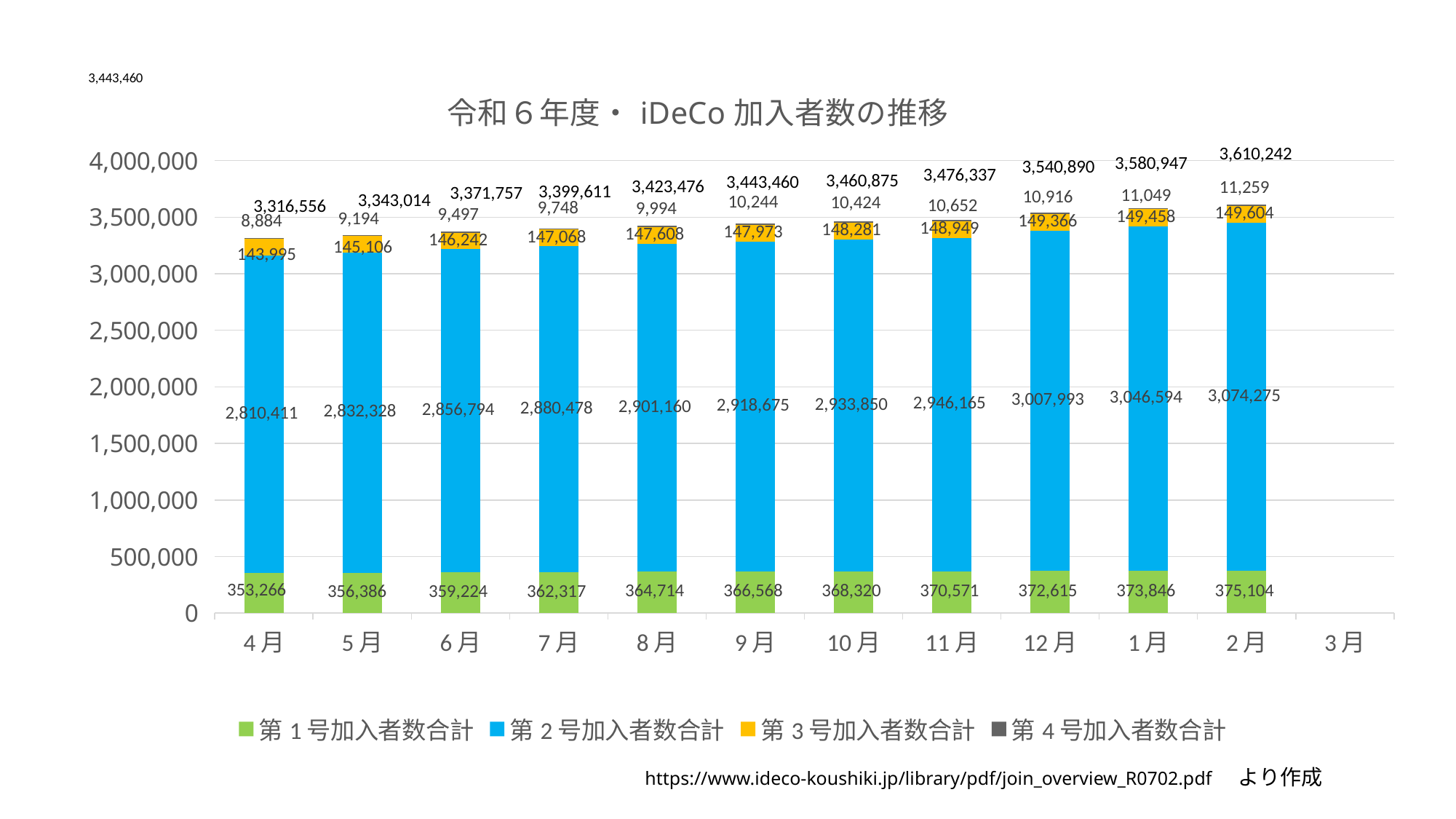
Which month with a bar has the lowest stacked total? 4月 What kind of chart is shown on the slide? Stacked bar chart What is the value of 第２号加入者数合計 for 4月? 2,810,411 What is the value of 第１号加入者数合計 for 2月? 375,104 How much larger is 第１号加入者数合計 in 2月 than in 4月? 21,838 Which month has the highest stacked total? 2月 What is the value of 第４号加入者数合計 for 12月? 10,916 How many series does the legend list? 4 Which is larger, 第２号加入者数合計 in 12月 or in 11月? 12月 What is the value of 第３号加入者数合計 for 9月? 147,973 Do the stacked totals rise or fall from 4月 to 2月? Rise What is the total of the stacked bar for 2月? 3,610,242